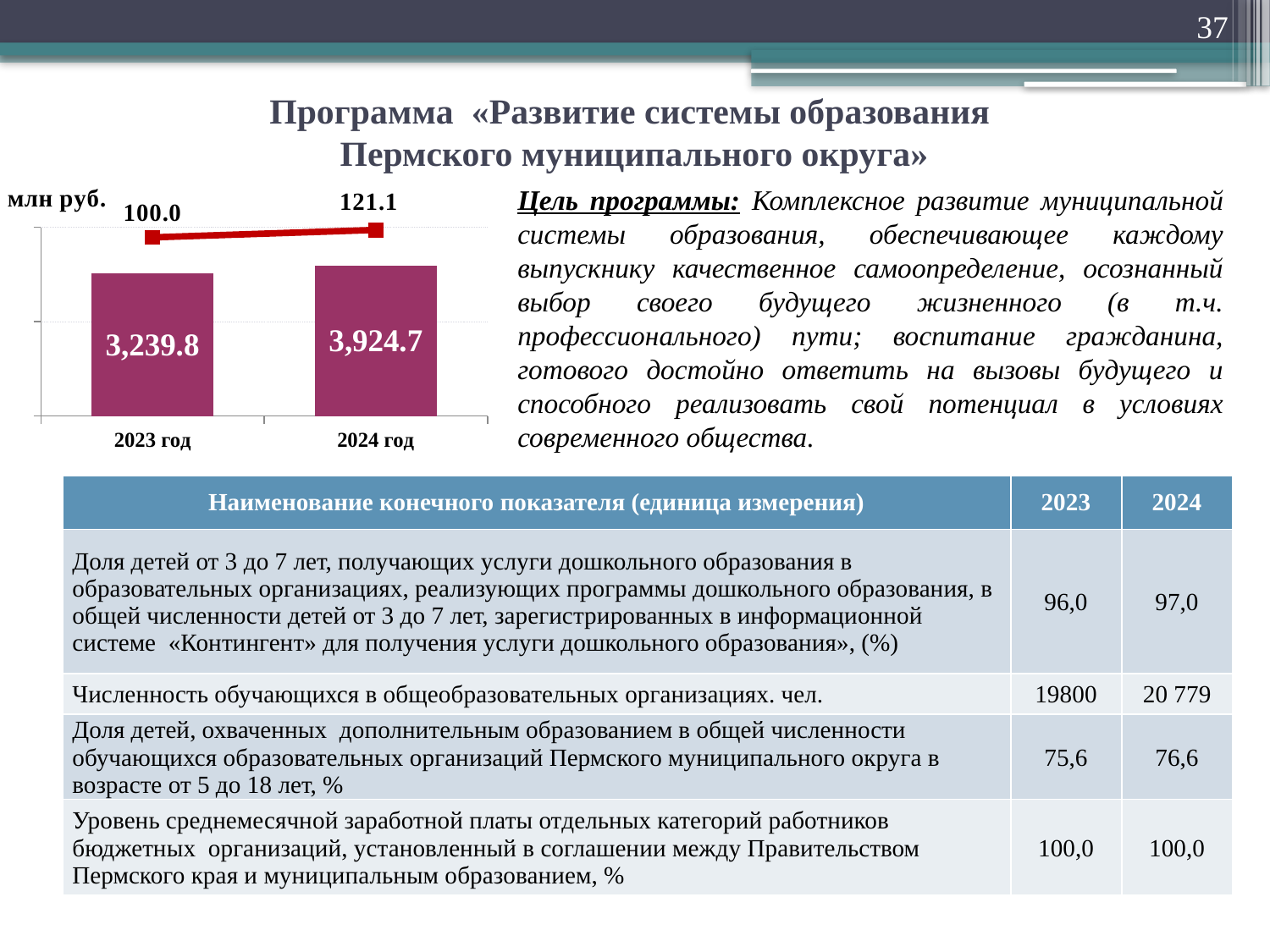
Is the bar value for 2024 год larger or smaller than the bar value for 2023 год? larger Which year has the lower bar value? 2023 год What is the difference between the bar values for 2024 год and 2023 год? 684.9 Do the bar values rise or fall from 2023 год to 2024 год? rise What value does the line show for 2024 год? 121.1 What kind of chart is shown on the slide? Combined bar and line chart What value does the line show for 2023 год? 100.0 What is the value of the bar for 2024 год? 3,924.7 How many categories are shown on the x axis of the chart? 2 What is the value of the bar for 2023 год? 3,239.8 Which year has the higher bar value? 2024 год What unit is indicated above the chart's vertical axis? млн руб.